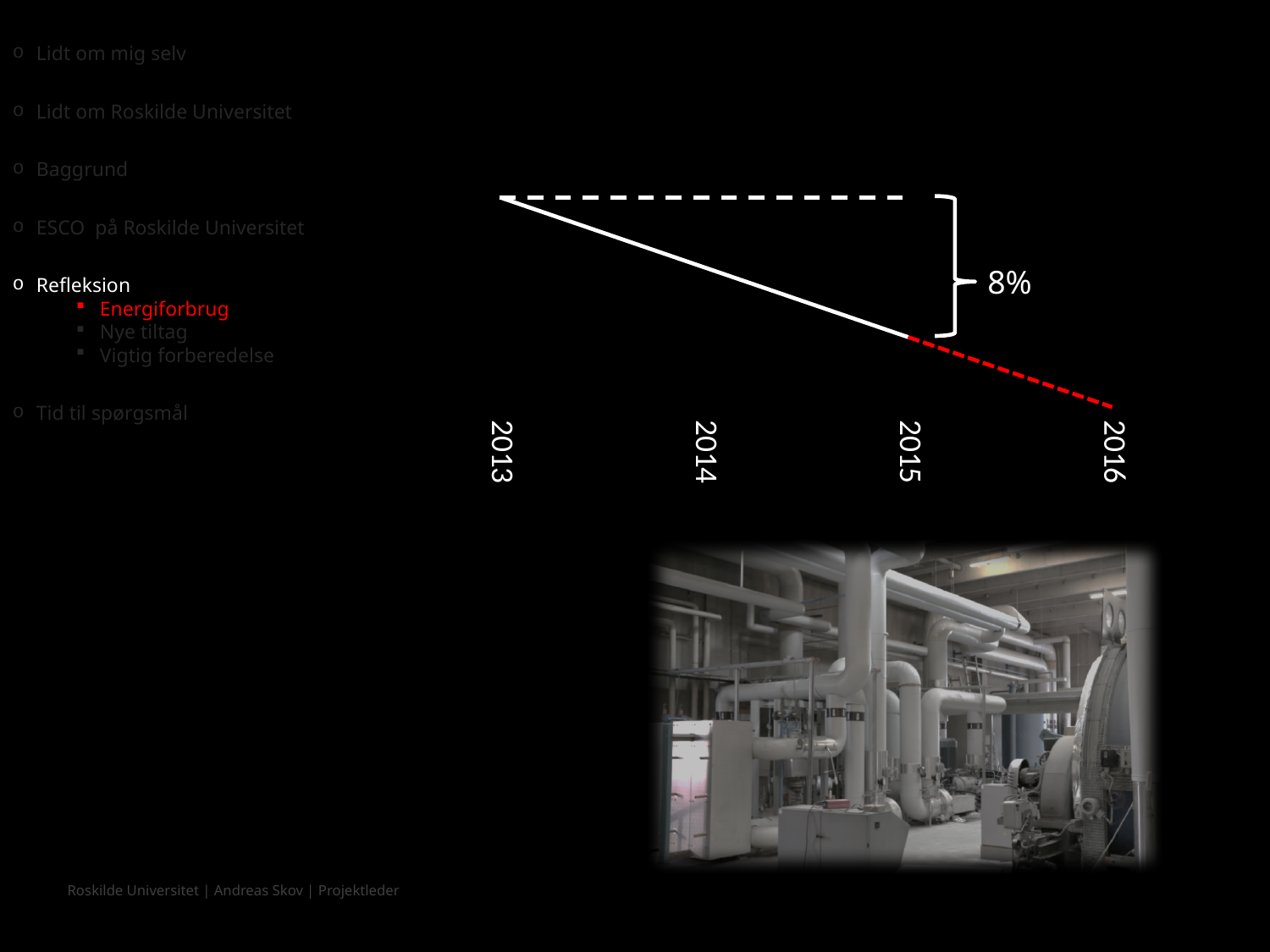
What is the first year labelled on the x axis of the chart? 2013 What is the last year labelled on the x axis of the chart? 2016 Which year on the x axis does the solid white line end at before the red dashed line begins? 2015 Does the red dashed line continue to rise or fall from 2015 to 2016? fall What kind of chart is shown on the slide? line chart What percentage is shown by the bracket at 2015 on the chart? 8% Does the solid white line rise or fall from 2013 to 2015? fall How many years are labelled on the x axis of the chart? 4